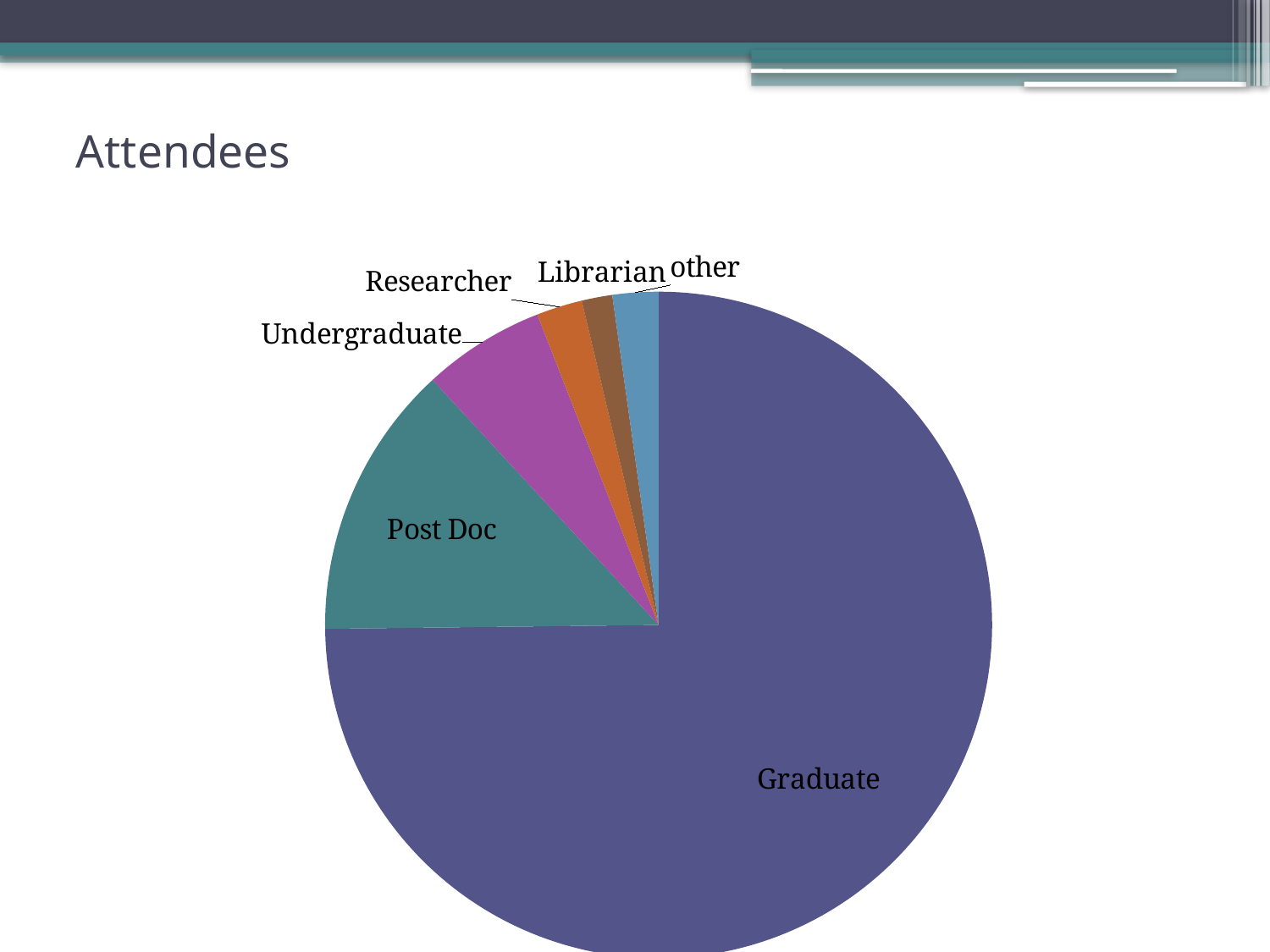
Which slice is larger, Post Doc or Librarian? Post Doc What colour is the Graduate slice of the pie chart? purple Which slice is larger, Undergraduate or Researcher? Undergraduate Which slice is larger, Post Doc or Undergraduate? Post Doc Which category has the largest slice of the pie chart? Graduate What kind of chart is shown on the slide? pie chart What is the title of the slide containing the pie chart? Attendees Which category has the smallest slice of the pie chart? Librarian How many categories (slices) does the pie chart have? 6 Which category has the second-largest slice of the pie chart? Post Doc